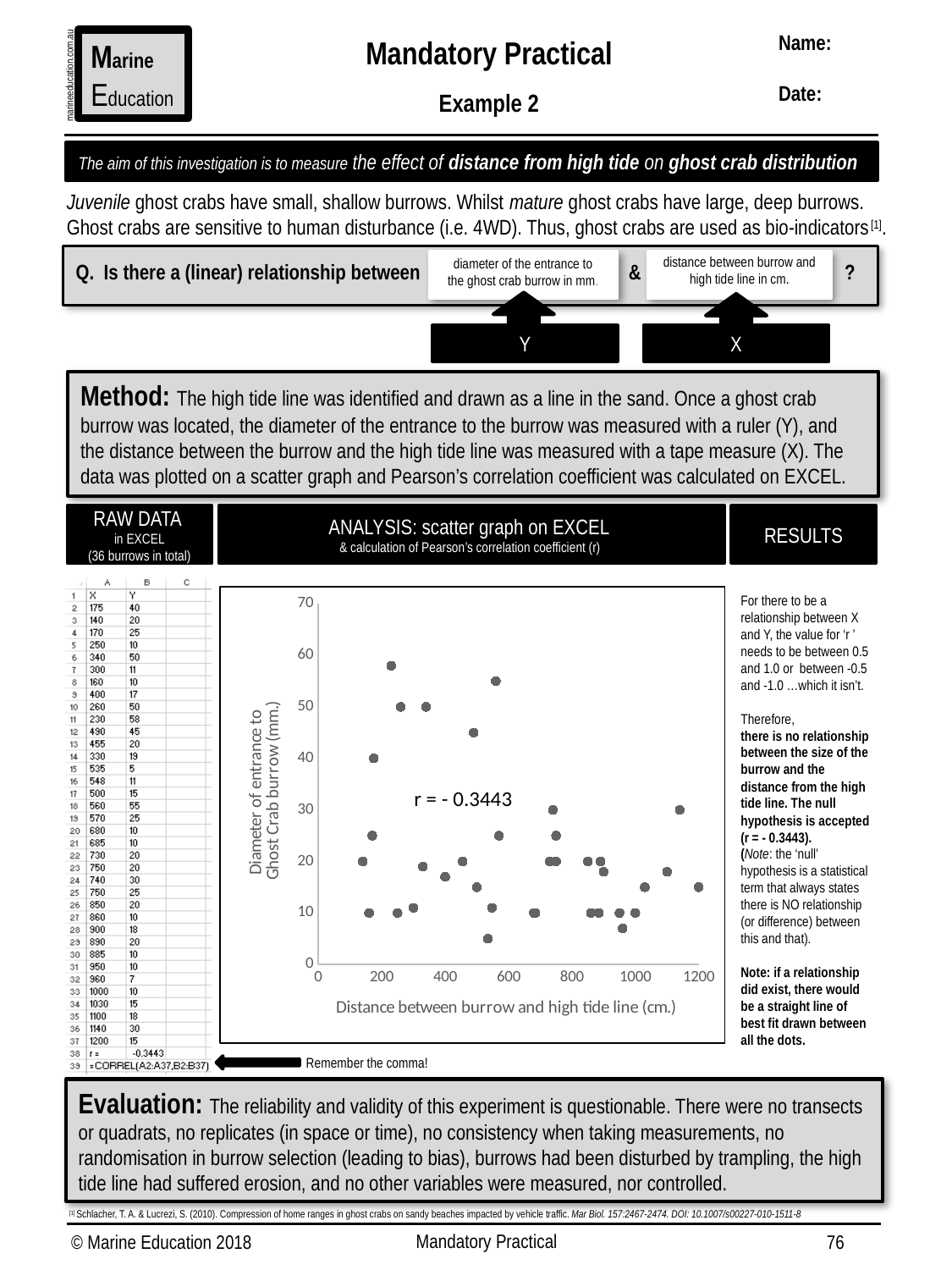
On the scatter chart, does burrow diameter generally rise or fall as distance from the high tide line increases? fall What is the largest tick value shown on the y axis of the scatter chart? 70 What is the largest tick value shown on the x axis of the scatter chart? 1200 Is the diameter for the burrow plotted at 1200 cm greater or less than 20? less What is the title of the y axis of the scatter chart? Diameter of entrance to Ghost Crab burrow (mm.) What value of r (Pearson's correlation coefficient) is printed on the scatter chart? -0.3443 What kind of chart is shown in the ANALYSIS section? scatter chart What is the title of the x axis of the scatter chart? Distance between burrow and high tide line (cm.) How many burrows (data points) are plotted on the scatter chart? 36